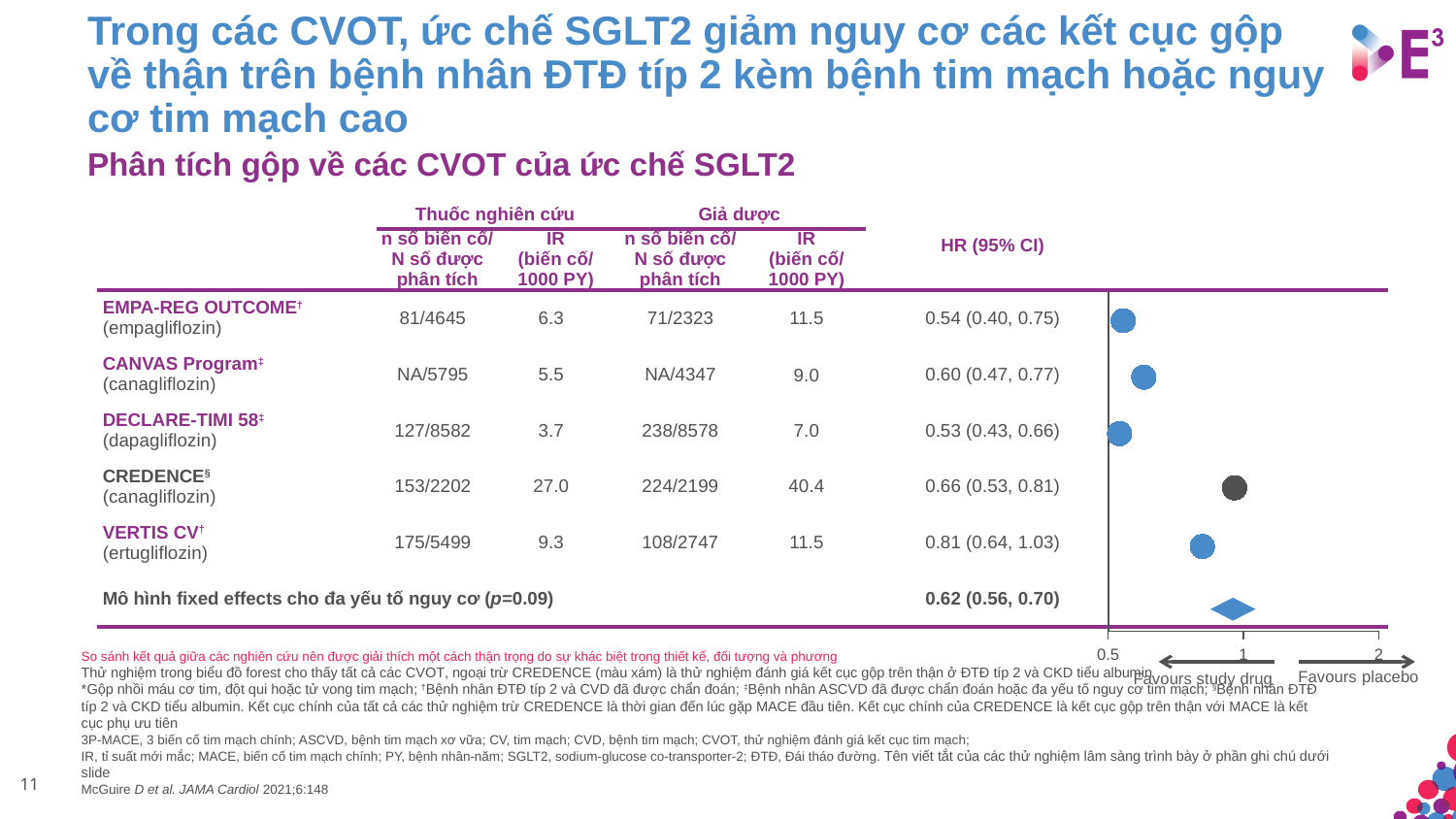
Is the hazard ratio for VERTIS CV greater or less than 1? less Which trial has the highest hazard ratio in the forest plot? VERTIS CV Which trial is shown with a grey marker in the forest plot? CREDENCE What is the pooled HR (95% CI) from the fixed effects model for multiple risk factors? 0.62 (0.56, 0.70) What is the HR (95% CI) for the VERTIS CV trial? 0.81 (0.64, 1.03) Which trial has the lowest hazard ratio in the forest plot? DECLARE-TIMI 58 What kind of chart is shown on the slide? Forest plot Which has the larger hazard ratio, CREDENCE or CANVAS Program? CREDENCE What is the difference between the hazard ratio of VERTIS CV and that of DECLARE-TIMI 58? 0.28 How many individual trials are shown in the forest plot (excluding the pooled estimate)? 5 What is the HR (95% CI) for the EMPA-REG OUTCOME trial in the forest plot? 0.54 (0.40, 0.75) What is the placebo incidence rate (events/1000 PY) for the CREDENCE trial? 40.4